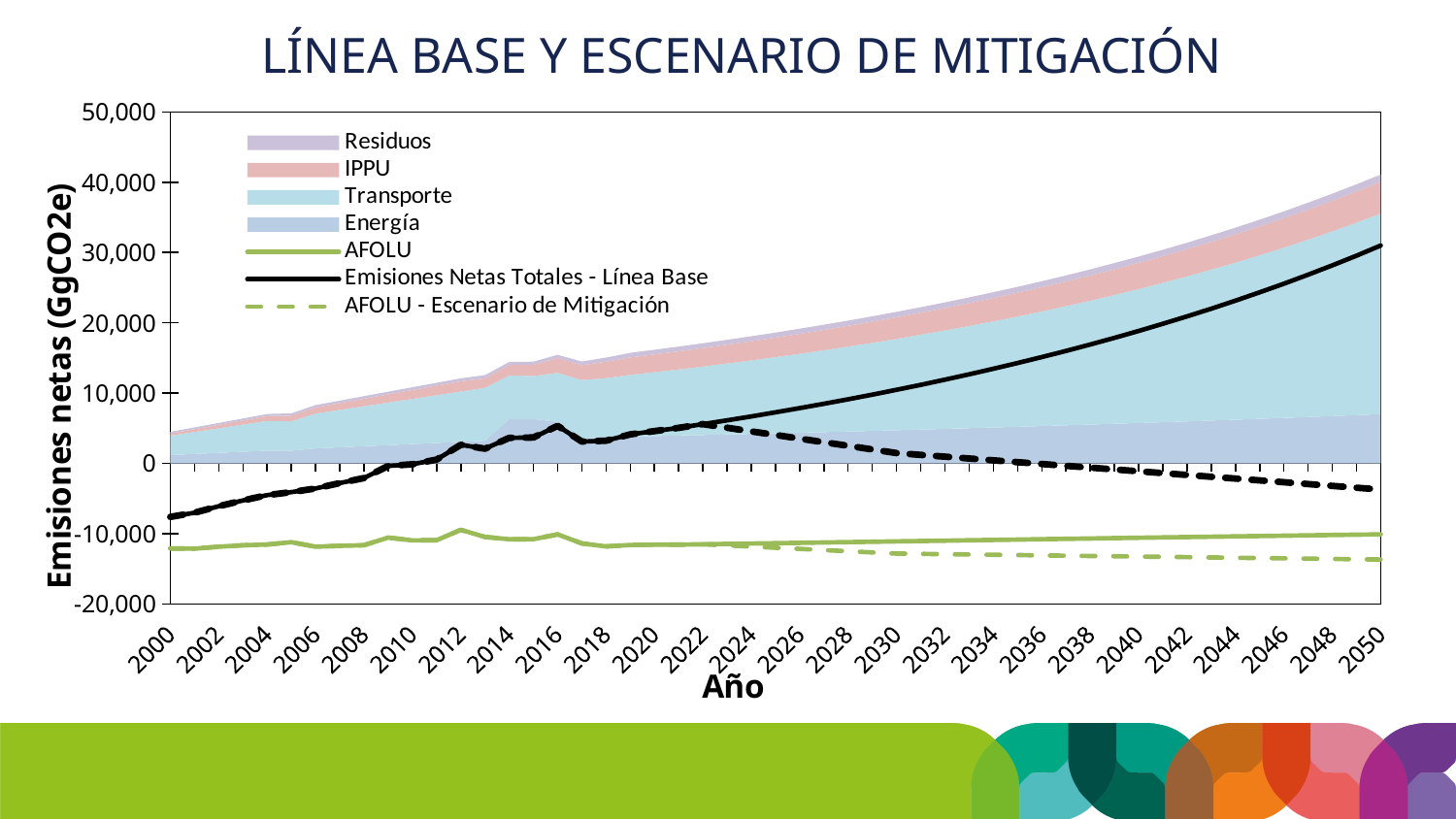
How many series does the chart legend list? 7 Which is larger in 2050: the 'Emisiones Netas Totales - Línea Base' value or the AFOLU value? Emisiones Netas Totales - Línea Base What is the first year shown on the x axis? 2000 Is the AFOLU value in 2000 greater or less than -10,000? less Is the top of the stacked area in 2050 greater or less than 30,000? greater What is the label of the vertical axis? Emisiones netas (GgCO2e) Is the value of 'Emisiones Netas Totales - Línea Base' in 2050 greater or less than 20,000? greater What is the last year shown on the x axis? 2050 What is the title of the chart on the slide? LÍNEA BASE Y ESCENARIO DE MITIGACIÓN Does the 'Emisiones Netas Totales - Línea Base' line rise or fall from 2000 to 2050? rise What kind of chart is shown on the slide? Stacked area chart with line series